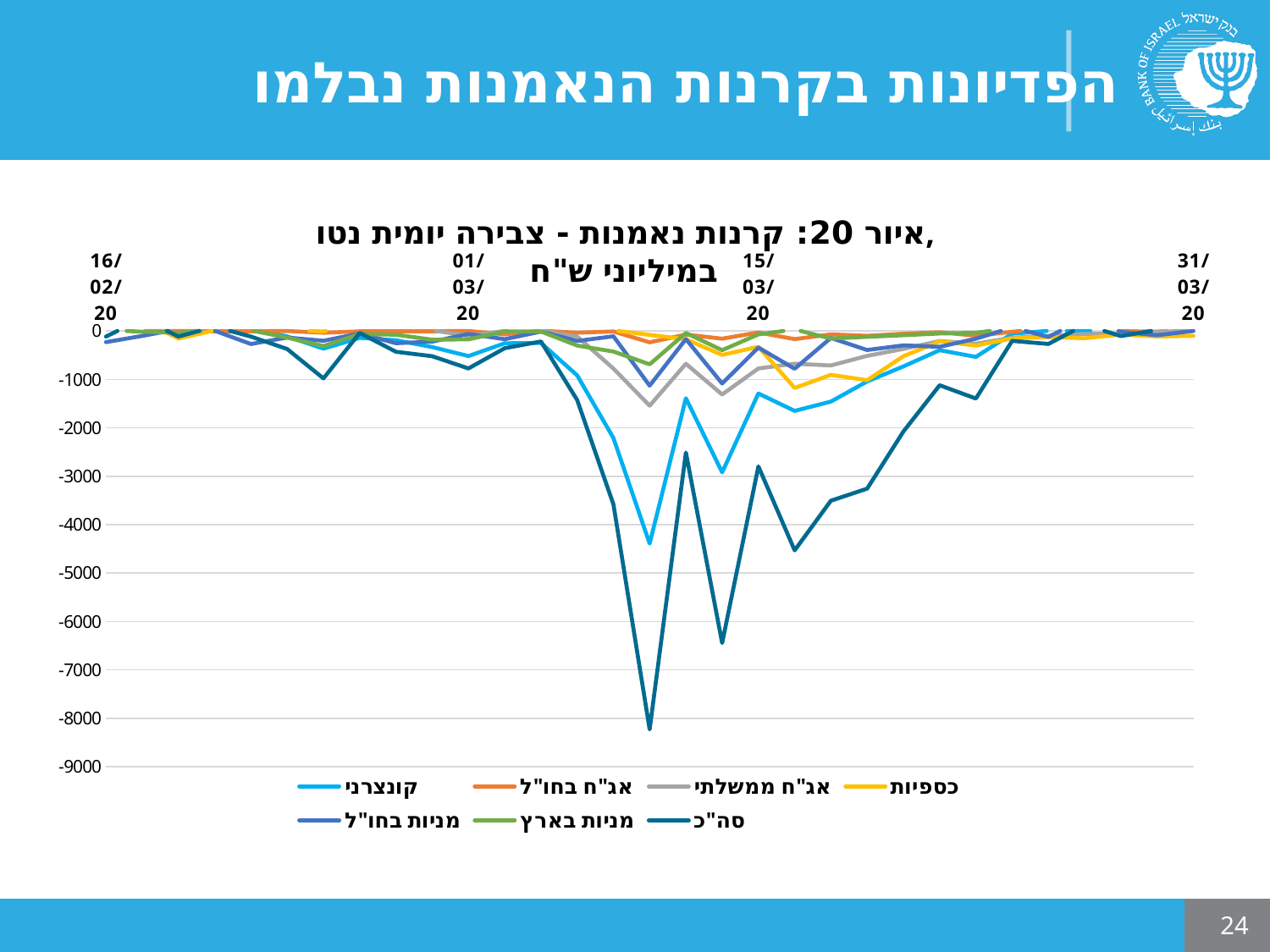
Is the lowest value of the סה"כ series greater or less than -7000? less Which series reaches the lowest value on the chart? סה"כ What is the last date label shown on the horizontal axis? 31/03/20 At its lowest point, which series is lower: קונצרני or אג"ח ממשלתי? קונצרני How many series does the chart legend list? 7 Around mid-March, do the values of the סה"כ series fall sharply or rise sharply compared with the start of the period? fall sharply What kind of chart is shown on the slide? line chart How many date labels are shown on the horizontal axis? 4 Is the lowest value of the קונצרני series greater or less than -4000? less Is the lowest value of the אג"ח ממשלתי series greater or less than -2000? greater What is the lowest value shown on the vertical axis? -9000 At its lowest point, which series is lower: סה"כ or קונצרני? סה"כ